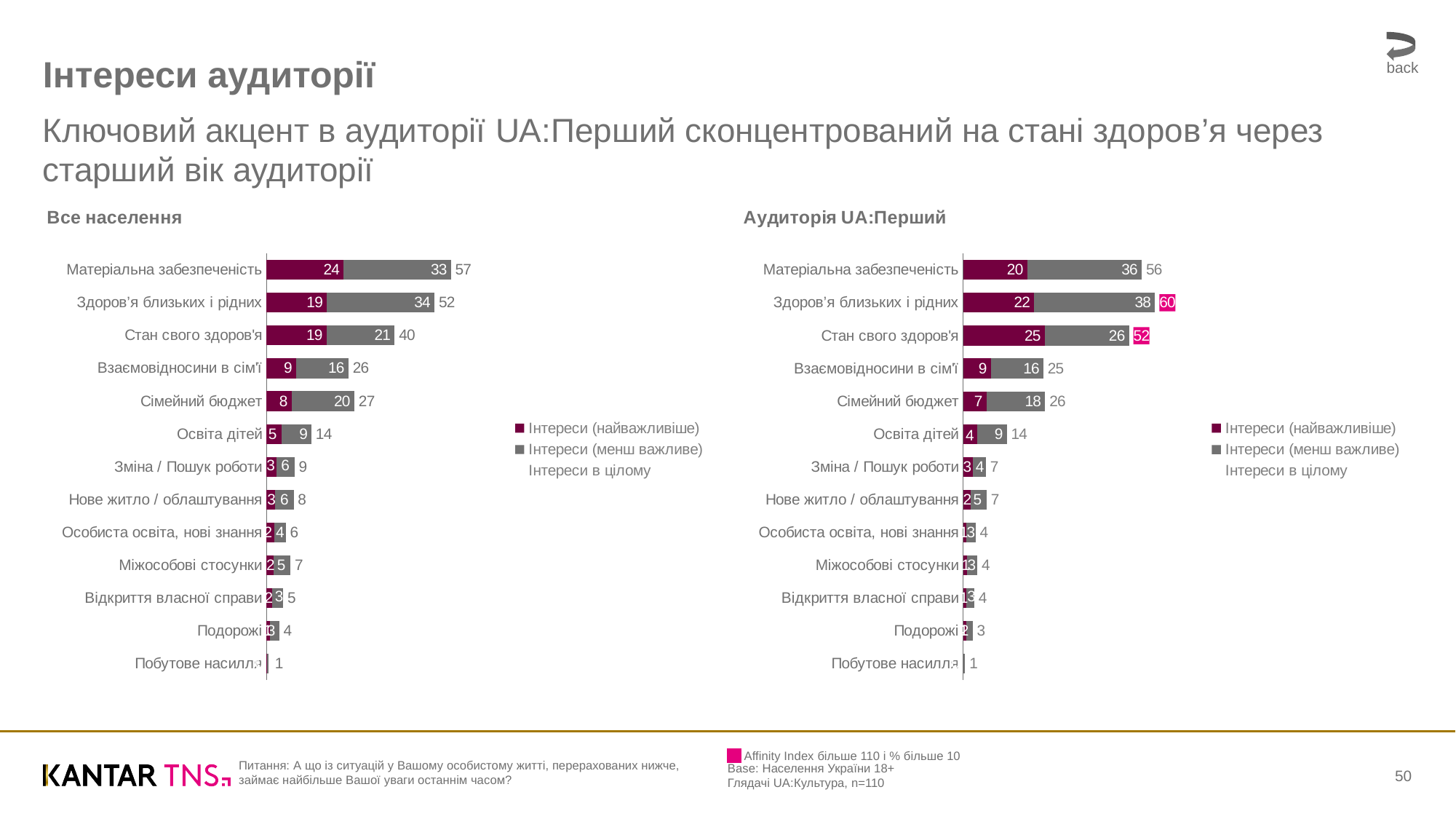
In the 'Все населення' chart, which category has the lowest 'Інтереси в цілому' value? Побутове насилля In the 'Все населення' chart, which category has the highest 'Інтереси в цілому' value? Матеріальна забезпеченість What type of chart is the 'Все населення' chart? Stacked bar chart In the 'Все населення' chart, what is the 'Інтереси (найважливіше)' value for 'Матеріальна забезпеченість'? 24 How many series does the legend of the 'Аудиторія UA:Перший' chart list? 3 How many categories are shown in the 'Все населення' chart? 13 In the 'Аудиторія UA:Перший' chart, what is the difference between the 'Інтереси в цілому' values for 'Матеріальна забезпеченість' and 'Сімейний бюджет'? 30 Which is larger: the 'Інтереси (найважливіше)' value for 'Стан свого здоров'я' in the 'Все населення' chart or in the 'Аудиторія UA:Перший' chart? Аудиторія UA:Перший In the 'Все населення' chart, what is the difference between the 'Інтереси (менш важливе)' values for 'Здоров'я близьких і рідних' and 'Стан свого здоров'я'? 13 In the 'Аудиторія UA:Перший' chart, what is the 'Інтереси в цілому' value for 'Здоров'я близьких і рідних'? 60 In the 'Аудиторія UA:Перший' chart, what is the 'Інтереси (менш важливе)' value for 'Стан свого здоров'я'? 26 In the 'Аудиторія UA:Перший' chart, which category has the highest 'Інтереси в цілому' value? Здоров'я близьких і рідних